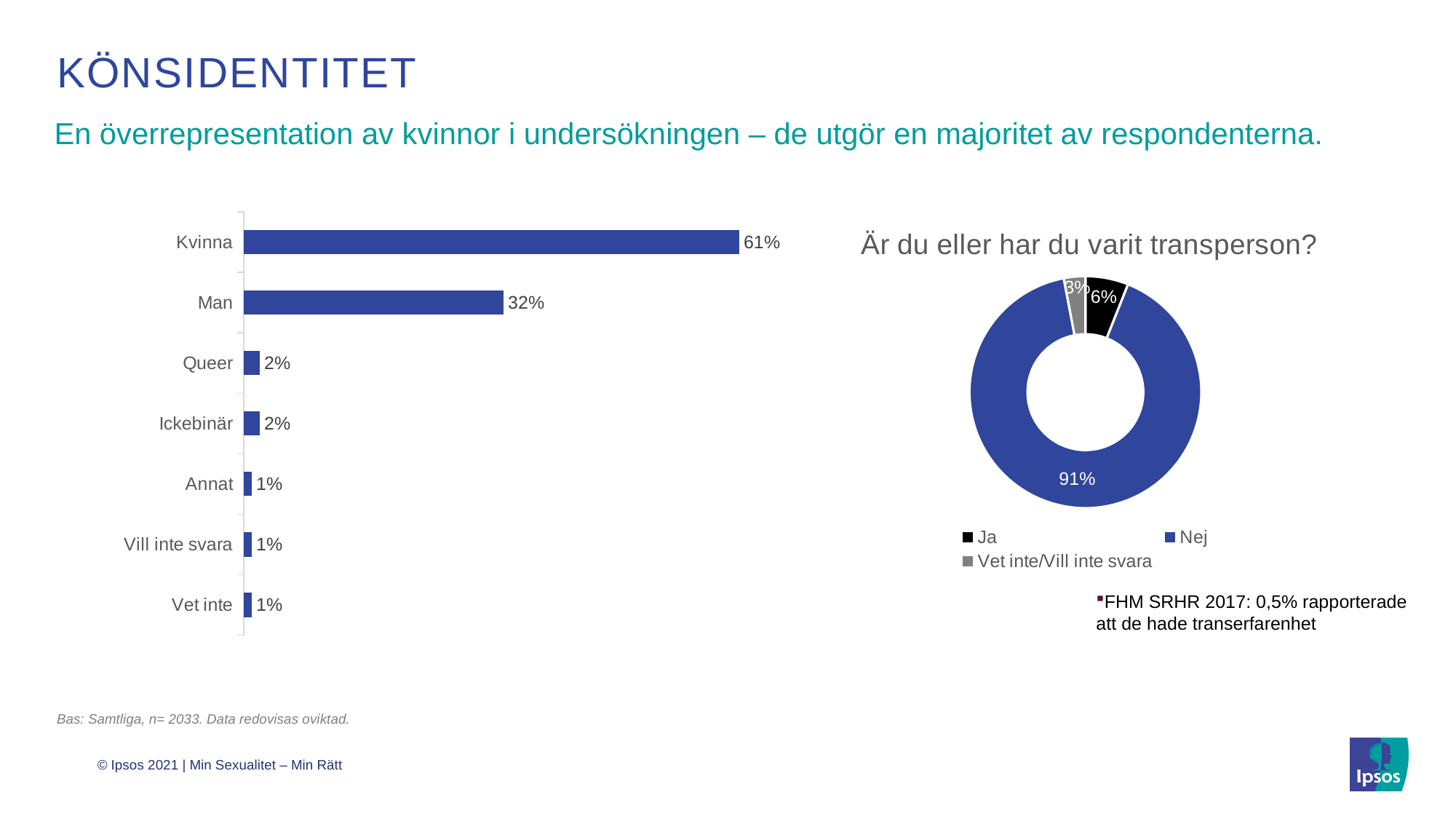
How many entries does the legend of the chart titled 'Är du eller har du varit transperson?' list? 3 What kind of chart is the chart on the left? Bar chart In the bar chart on the left, what is the value for Queer? 2% In the bar chart on the left, what is the value for Man? 32% In the bar chart on the left, what is the difference between the values for Kvinna and Man? 29 percentage points What kind of chart is the chart titled 'Är du eller har du varit transperson?'? Doughnut chart How many categories are shown in the bar chart on the left? 7 In the bar chart on the left, which is larger, the value for Man or the value for Ickebinär? Man In the bar chart on the left, which category has the highest value? Kvinna In the chart titled 'Är du eller har du varit transperson?', what share is Ja? 6% In the bar chart on the left, what is the value for Kvinna? 61% In the chart titled 'Är du eller har du varit transperson?', what share is Nej? 91%